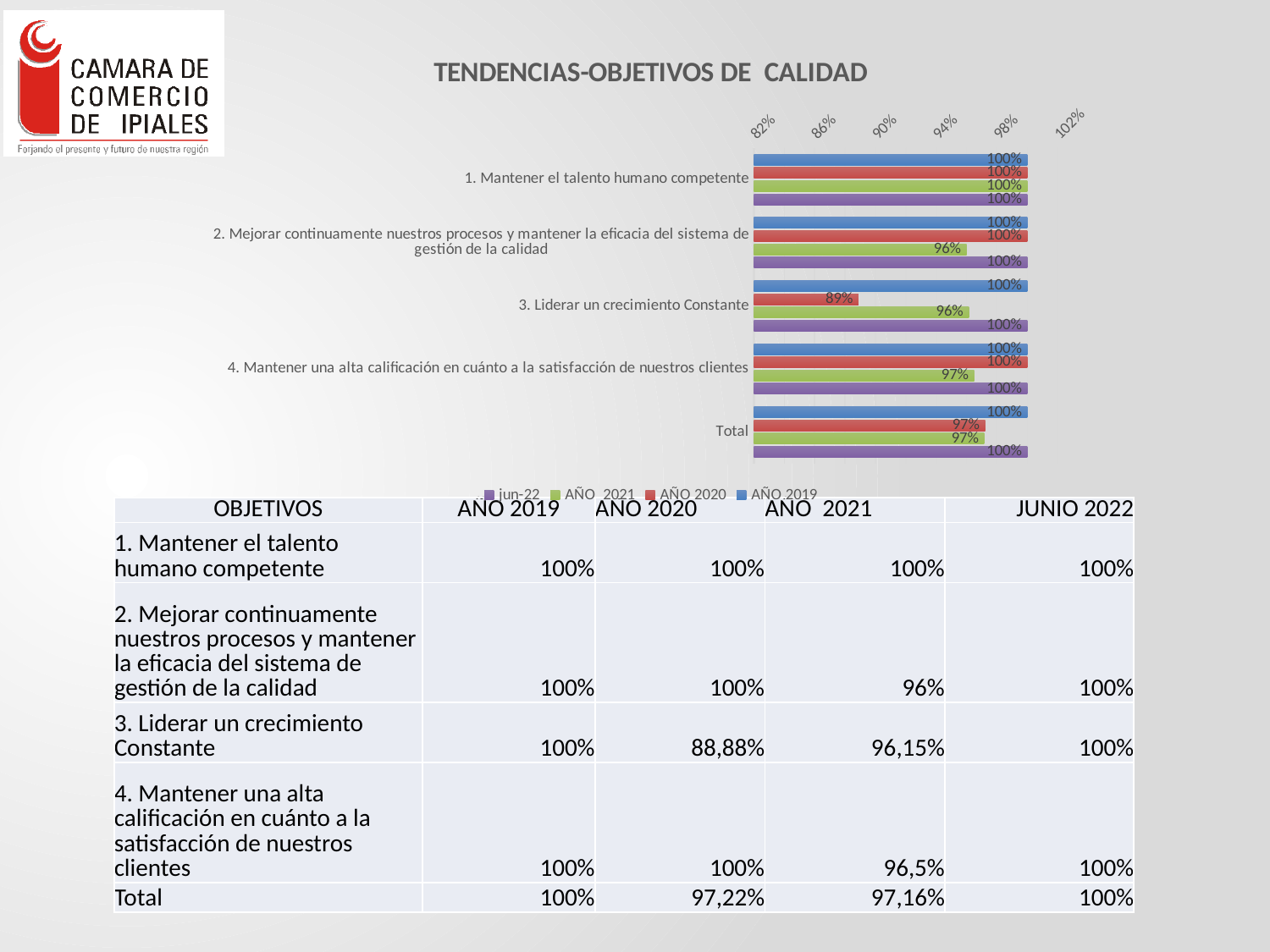
According to the chart's data label, what is the AÑO 2021 value for '2. Mejorar continuamente nuestros procesos y mantener la eficacia del sistema de gestión de la calidad'? 96% Using the chart's data labels, what is the difference between the AÑO 2019 and AÑO 2020 values for '3. Liderar un crecimiento Constante'? 11% For '3. Liderar un crecimiento Constante', which is larger on the chart: the AÑO 2021 value or the AÑO 2020 value? AÑO 2021 Which category has the lowest AÑO 2020 value on the chart? 3. Liderar un crecimiento Constante How many series does the chart legend list? 4 According to the chart's data label, what is the AÑO 2020 value for '3. Liderar un crecimiento Constante'? 89% Which series is shown in purple on the chart? jun-22 How many categories are plotted on the chart? 5 According to the chart's data label, what is the AÑO 2020 value for 'Total'? 97% What type of chart is shown on the slide? bar chart What is the title of the chart? TENDENCIAS-OBJETIVOS DE CALIDAD According to the chart's data label, what is the AÑO 2021 value for '4. Mantener una alta calificación en cuánto a la satisfacción de nuestros clientes'? 97%